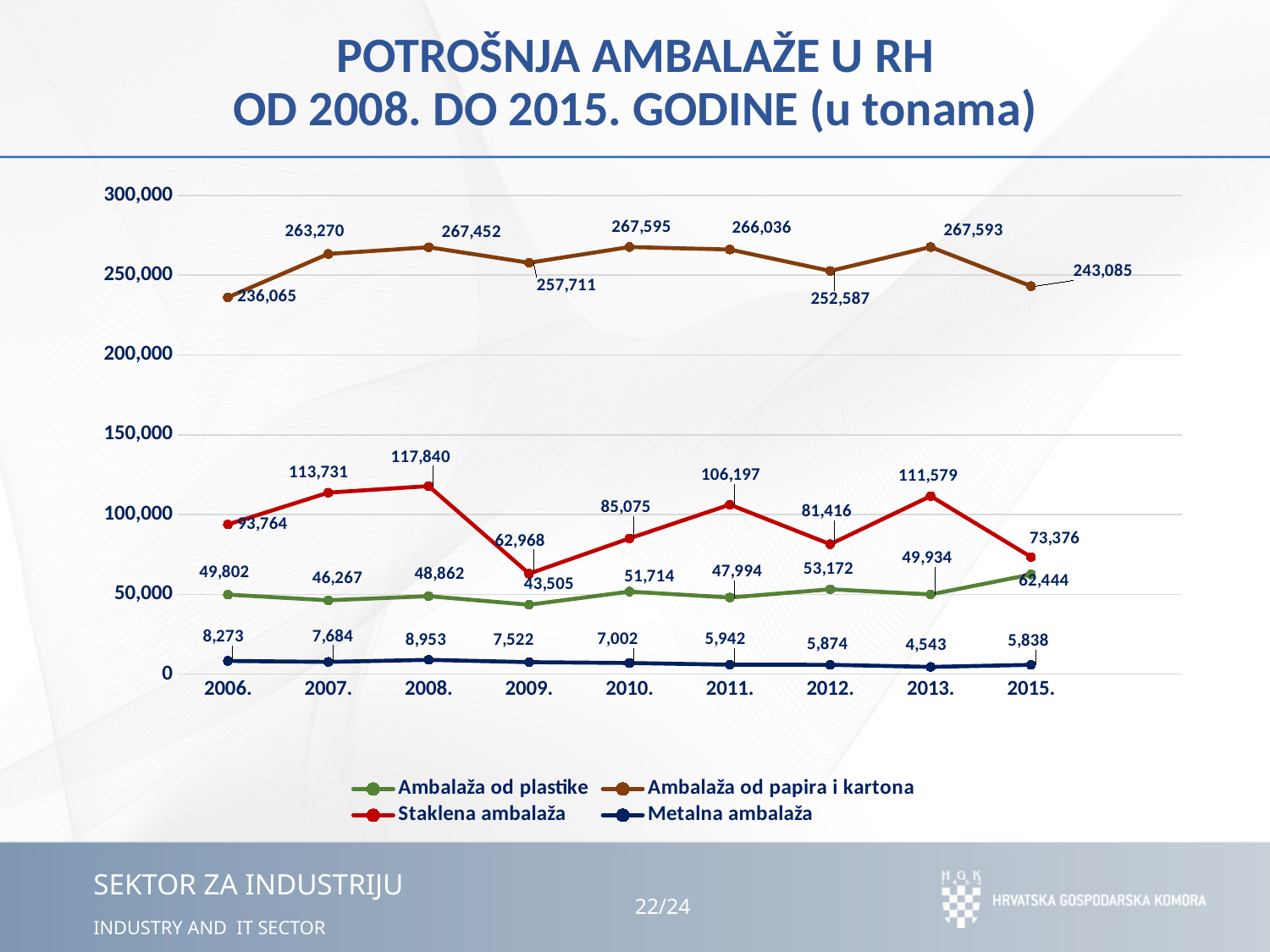
What is the difference between Staklena ambalaža in 2008. and in 2009.? 54,872 Is the value for Ambalaža od papira i kartona in 2015. greater or less than 250,000? less What is the value for Staklena ambalaža in 2009.? 62,968 What is the value for Ambalaža od plastike in 2015.? 62,444 What is the value for Ambalaža od papira i kartona in 2006.? 236,065 How many years are shown on the x axis? 9 What is the value for Metalna ambalaža in 2013.? 4,543 In which year is Staklena ambalaža highest? 2008. In which year is Metalna ambalaža lowest? 2013. Which is larger: Ambalaža od plastike in 2012. or in 2013.? 2012. What kind of chart is shown on the slide? line chart How many series does the legend list? 4